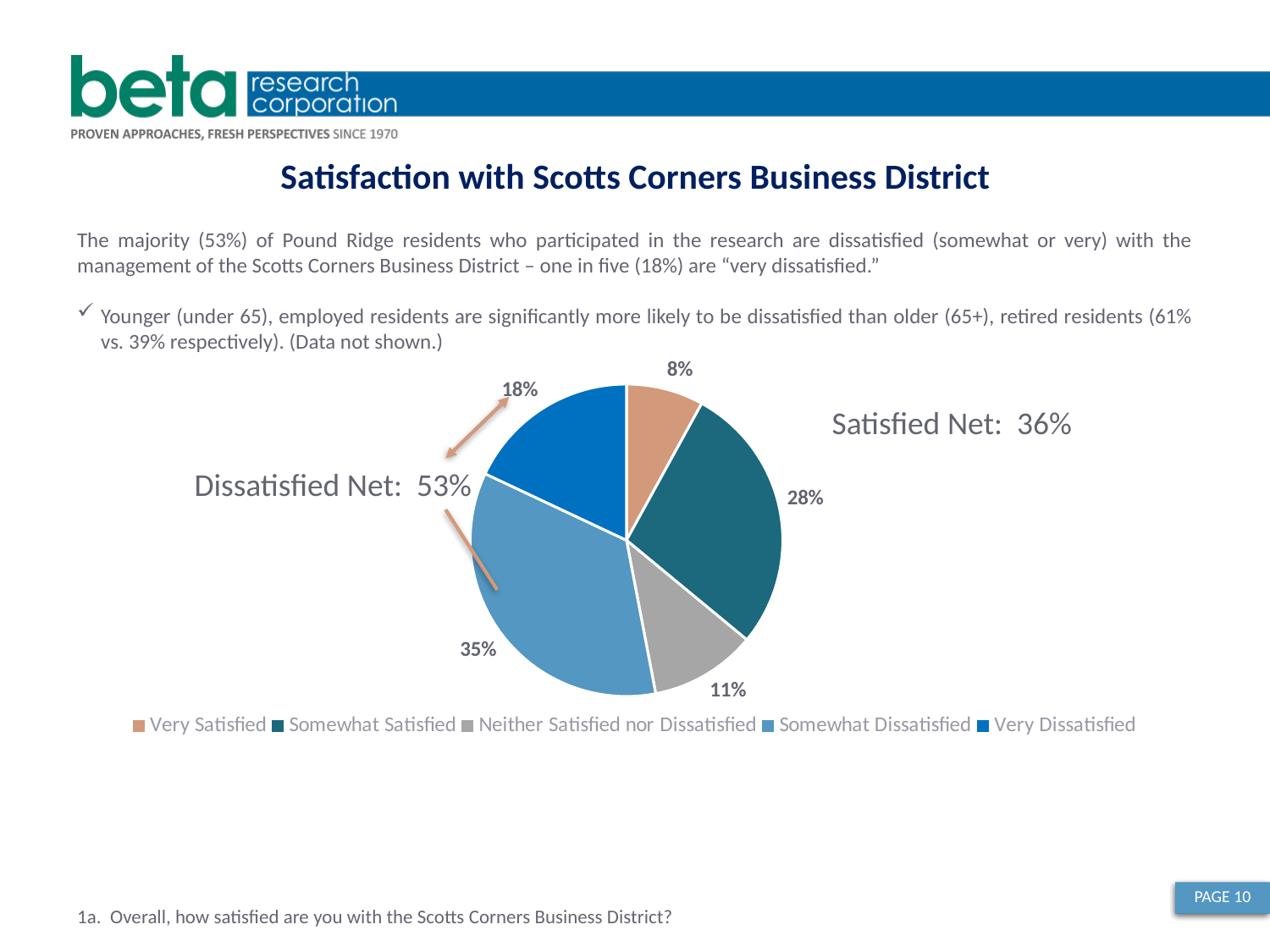
Which response category has the smallest share of the pie? Very Satisfied What percentage of respondents are Somewhat Satisfied? 28% What percentage of respondents are Very Satisfied? 8% What is the difference between the Somewhat Dissatisfied and Somewhat Satisfied shares? 7% What is the Dissatisfied Net percentage shown next to the chart? 53% What percentage of respondents are Somewhat Dissatisfied? 35% What percentage of respondents are Neither Satisfied nor Dissatisfied? 11% What kind of chart is shown on the slide? pie chart What percentage of respondents are Very Dissatisfied? 18% How many categories does the legend list? 5 Which response category has the largest share of the pie? Somewhat Dissatisfied Which is larger, the Very Dissatisfied share or the Neither Satisfied nor Dissatisfied share? Very Dissatisfied